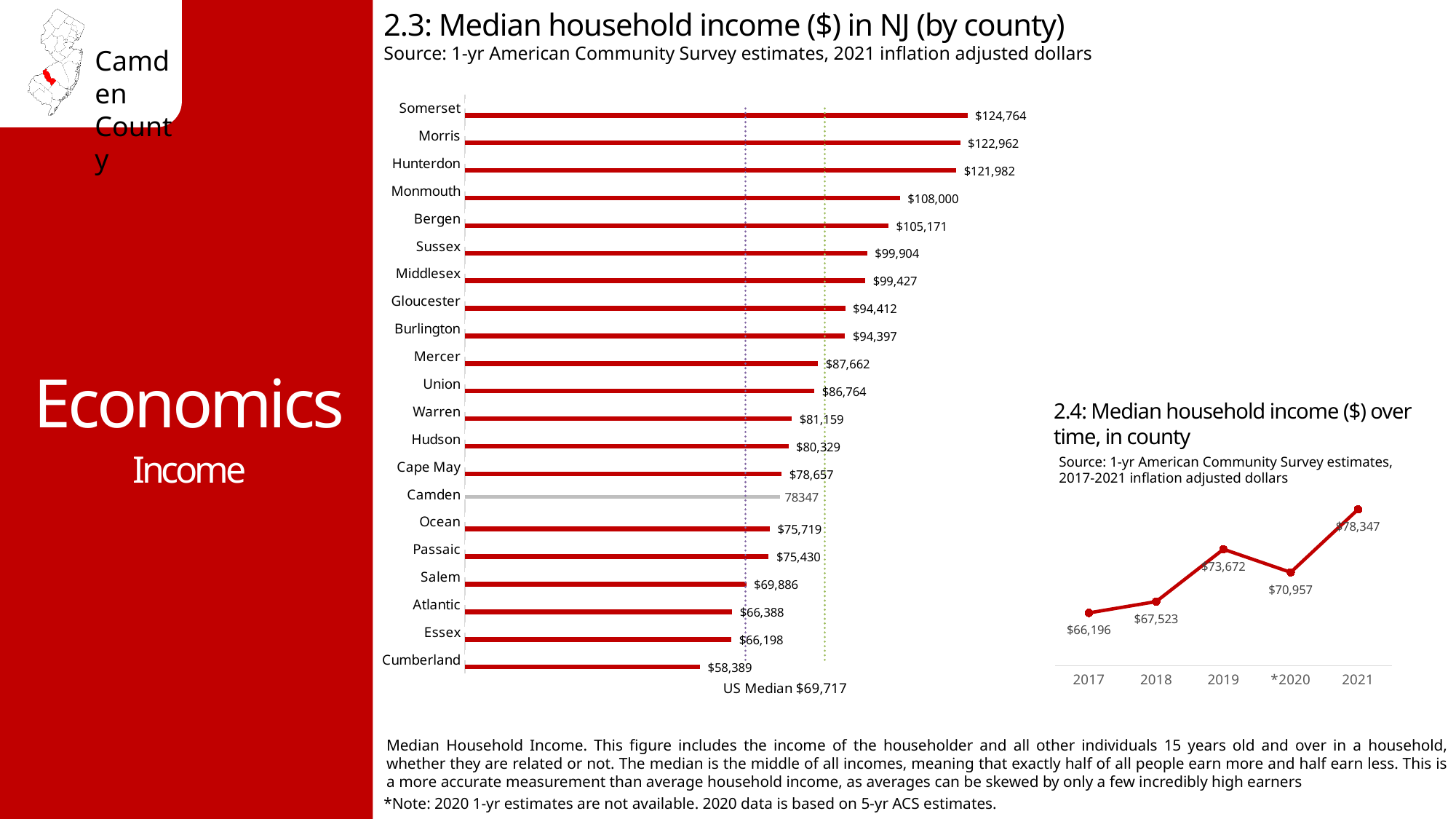
In chart 2.3 (Median household income by county), how many counties are shown? 21 In chart 2.4 (Median household income over time), did median household income rise or fall from 2019 to 2020? Fall In chart 2.4 (Median household income over time), how much did median household income increase from 2017 to 2021? $12,151 In chart 2.3 (Median household income by county), which county has the highest median household income? Somerset In chart 2.3 (Median household income by county), what value is labelled for Camden? 78347 What kind of chart is chart 2.3 (Median household income by county)? Bar chart In chart 2.3 (Median household income by county), which has a higher median household income, Monmouth or Bergen? Monmouth In chart 2.3 (Median household income by county), what is the difference between Somerset's and Cumberland's median household income? $66,375 In chart 2.4 (Median household income over time), which year has the lowest median household income? 2017 In chart 2.3 (Median household income by county), what is the median household income for Somerset? $124,764 In chart 2.4 (Median household income over time), what is the median household income for 2021? $78,347 In chart 2.3 (Median household income by county), which county has the lowest median household income? Cumberland